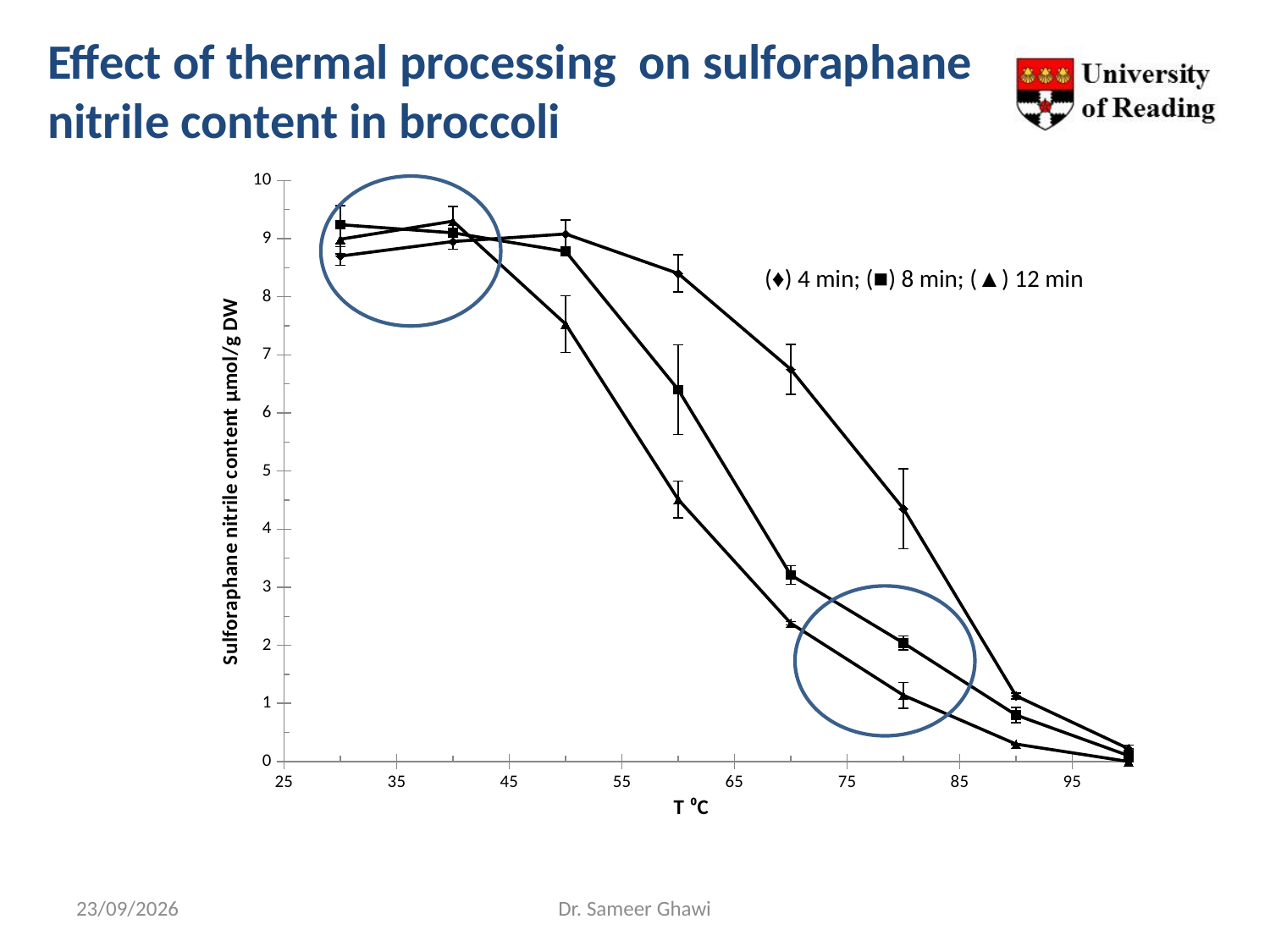
What are the three series named in the legend? 4 min, 8 min, 12 min Is the value for the 4 min series at 70 °C greater or less than 6? greater At 60 °C, which series has the higher value, 8 min or 12 min? 8 min Which series has the lowest value at 90 °C? 12 min How many series does the legend list? 3 What is the label of the y axis? Sulforaphane nitrile content µmol/g DW Do the sulforaphane nitrile values rise or fall as temperature increases from 50 °C to 100 °C? Fall How many temperature points are plotted for each series? 8 Which series has the highest value at 70 °C? 4 min Is the value for the 8 min series at 80 °C greater or less than 3? less Is the value for the 12 min series at 60 °C greater or less than 5? less What kind of chart is shown on the slide? Line chart